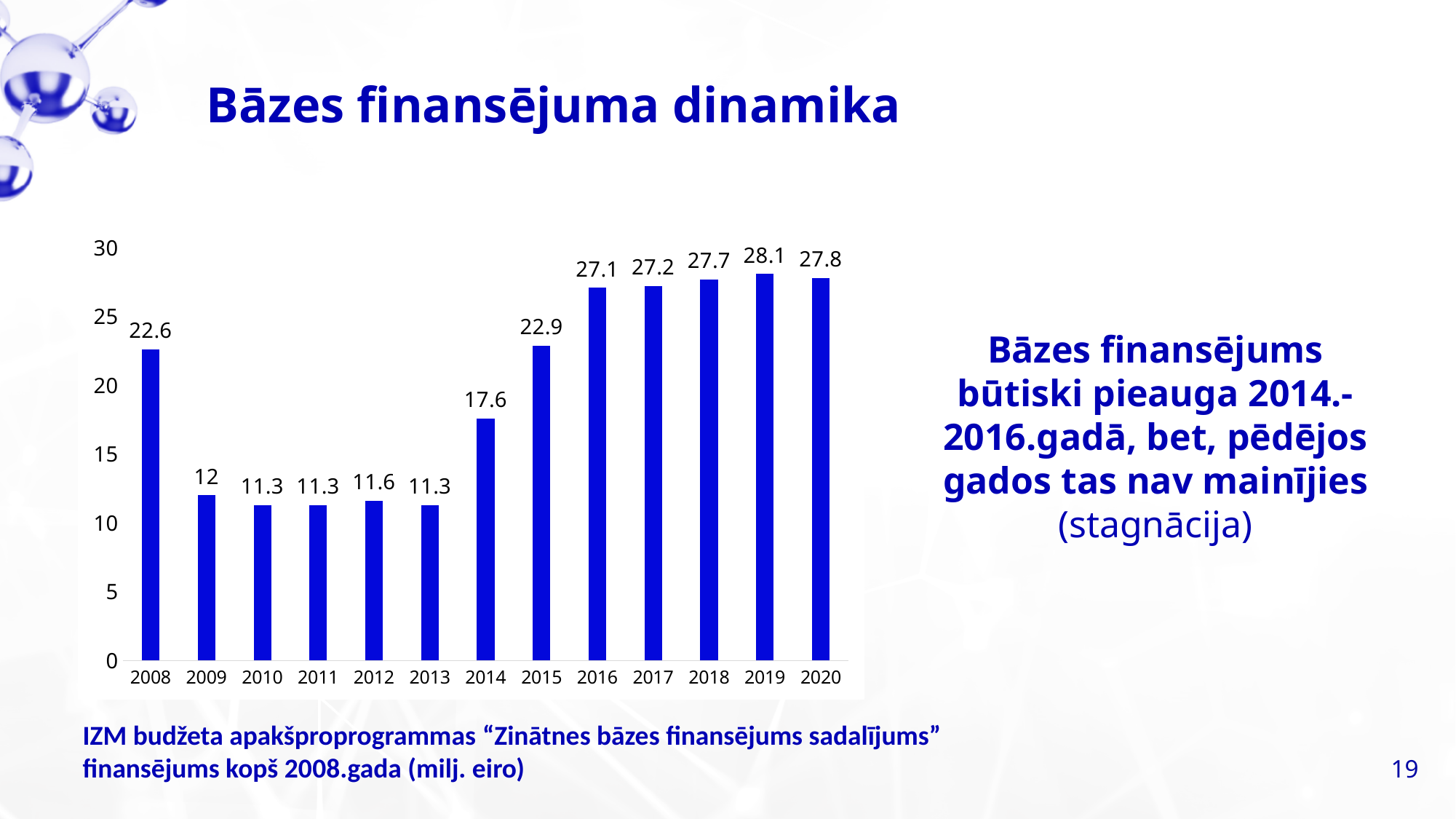
What is the difference between the values for 2020 and 2008? 5.2 What is the value for 2019? 28.1 Is the value for 2016 greater or less than 25? greater Which year has the highest value? 2019 What is the value for 2014? 17.6 What kind of chart is shown on the slide? bar chart What is the difference between the values for 2015 and 2014? 5.3 Do the values rise or fall from 2013 to 2016? rise How many years are shown on the x axis? 13 What is the value for 2012? 11.6 What is the value for 2008? 22.6 Which is larger, the value for 2009 or the value for 2013? 2009